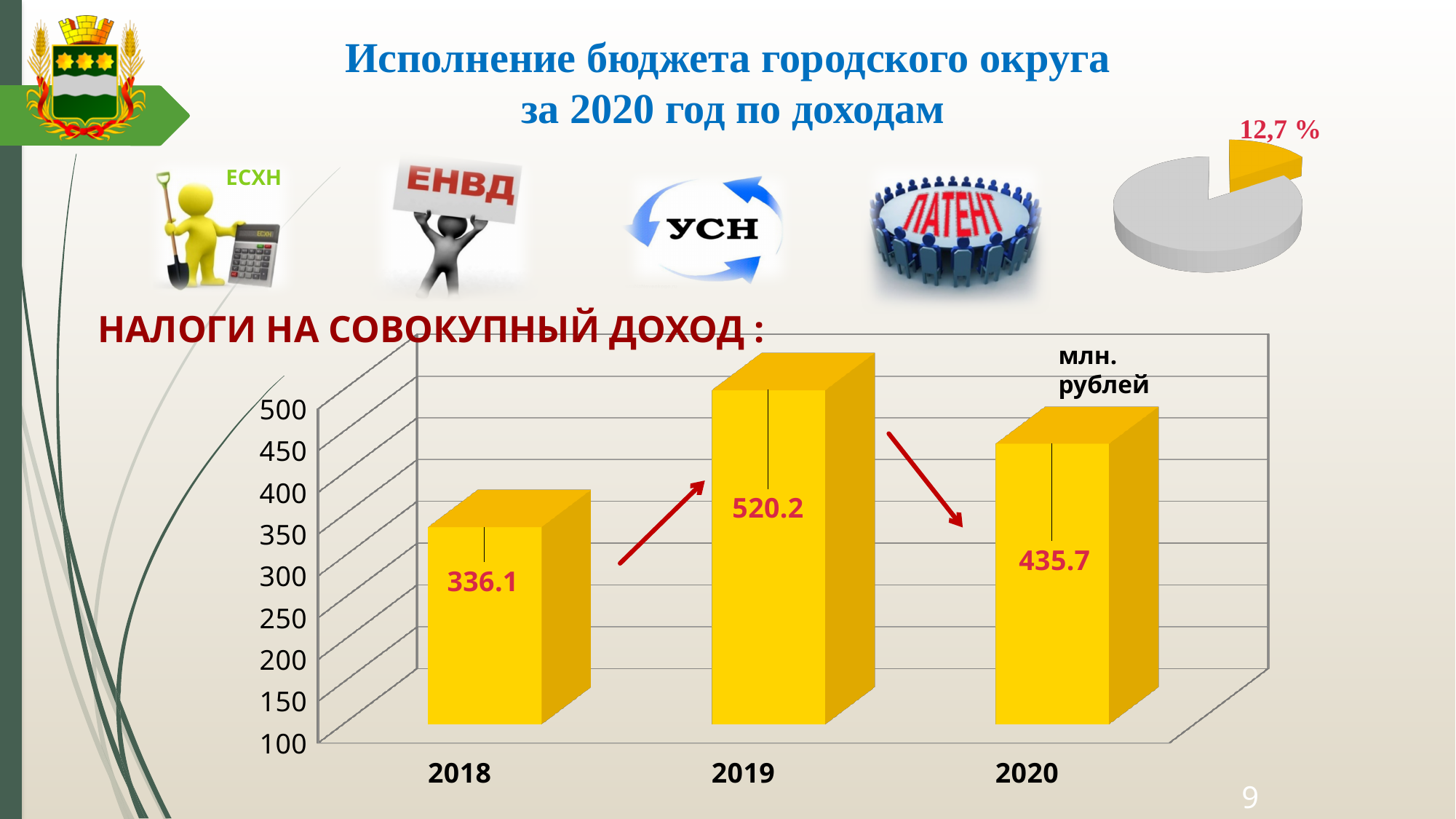
On the pie chart in the top right corner, what share is shown for the highlighted slice? 12,7 % On the bar chart, is the value for 2020 greater or less than 400? greater On the bar chart, what is the value for 2020? 435.7 On the bar chart, which is larger, the value for 2020 or the value for 2018? 2020 On the bar chart, which year has the lowest value? 2018 How many years are shown on the bar chart? 3 What kind of chart is the large chart at the bottom of the slide? bar chart On the bar chart, which year has the highest value? 2019 On the bar chart, what is the value for 2018? 336.1 On the bar chart, what is the value for 2019? 520.2 On the bar chart, what is the difference between the 2019 and 2020 values? 84.5 On the bar chart, what is the difference between the 2019 and 2018 values? 184.1